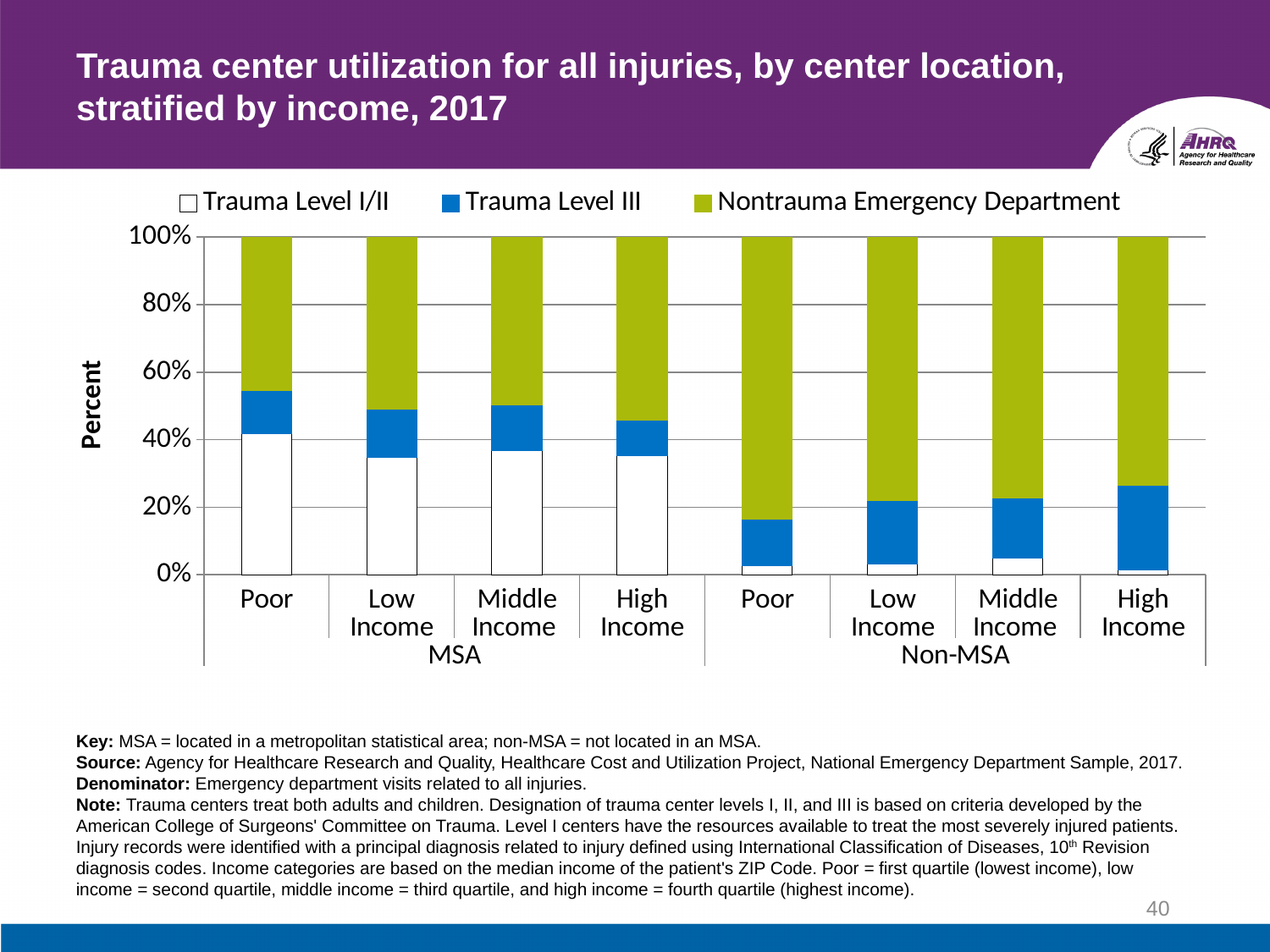
How many bars are plotted in the chart? 8 Is the Trauma Level I/II share for Poor in the MSA group greater or less than 40%? greater Is the Trauma Level I/II share larger for Poor in the MSA group or Poor in the Non-MSA group? Poor (MSA) Is the Nontrauma Emergency Department share larger for High Income in the MSA group or High Income in the Non-MSA group? High Income (Non-MSA) Which category has the largest Trauma Level I/II share? Poor (MSA) Is the Nontrauma Emergency Department share for High Income in the Non-MSA group greater or less than 60%? greater What kind of chart is shown on the slide? Stacked bar chart What is the label on the vertical axis? Percent Is the Trauma Level I/II share for Poor in the Non-MSA group greater or less than 20%? less What are the three series listed in the legend? Trauma Level I/II, Trauma Level III, Nontrauma Emergency Department How many series does the legend list? 3